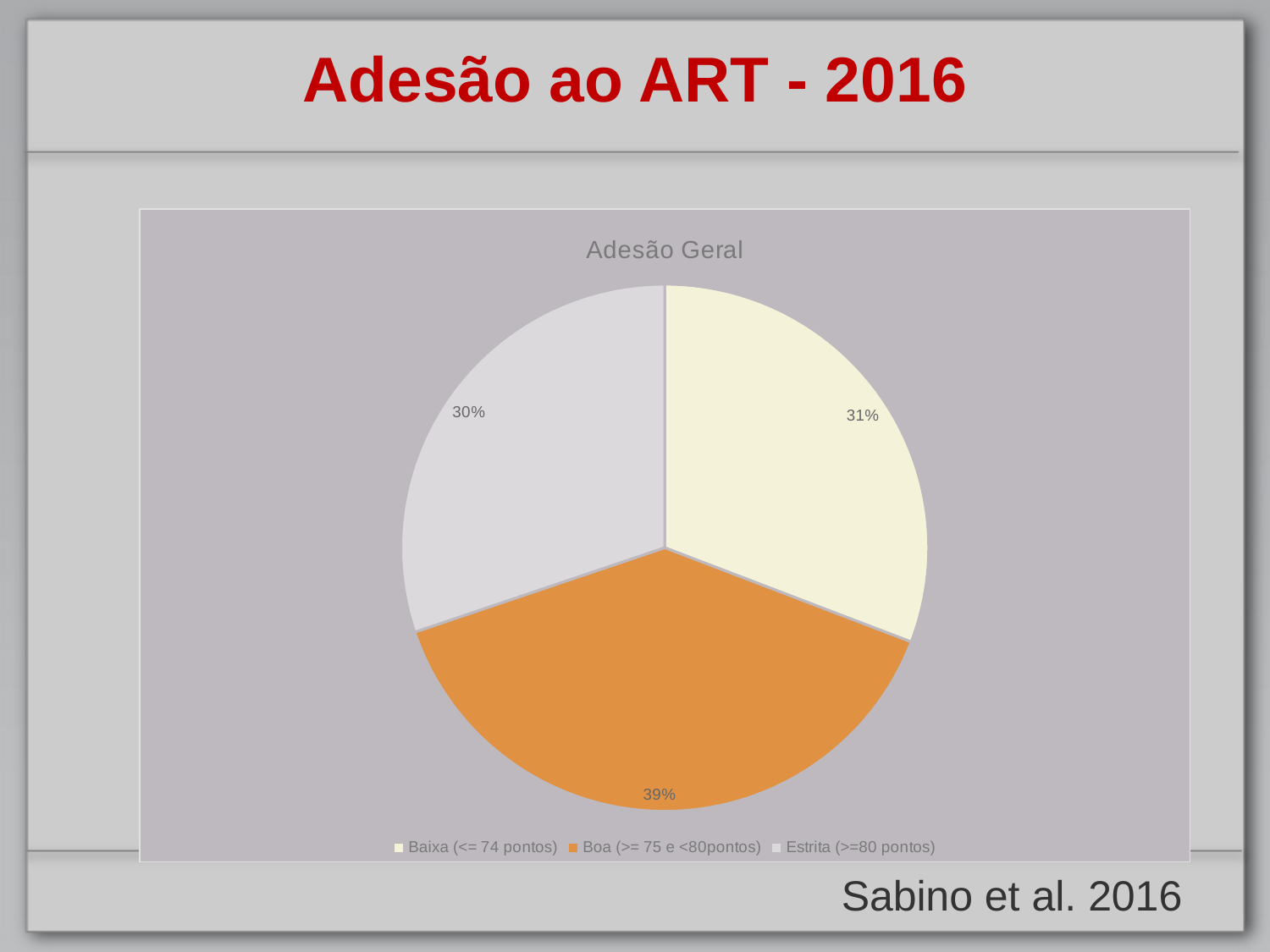
What share of the pie is labelled Boa (>= 75 e <80pontos)? 39% What is the difference in percentage points between the Boa (>= 75 e <80pontos) slice and the Estrita (>=80 pontos) slice? 9 How many slices does the pie chart have? 3 Which is larger, the Boa (>= 75 e <80pontos) slice or the Baixa (<= 74 pontos) slice? Boa (>= 75 e <80pontos) What kind of chart is shown on the slide? pie chart Which category has the largest slice of the pie? Boa (>= 75 e <80pontos) What colour is the Boa (>= 75 e <80pontos) slice? orange What share of the pie is labelled Estrita (>=80 pontos)? 30% What share of the pie is labelled Baixa (<= 74 pontos)? 31% How many entries does the legend list? 3 What is the title of the chart? Adesão Geral What is the difference in percentage points between the Boa (>= 75 e <80pontos) slice and the Baixa (<= 74 pontos) slice? 8